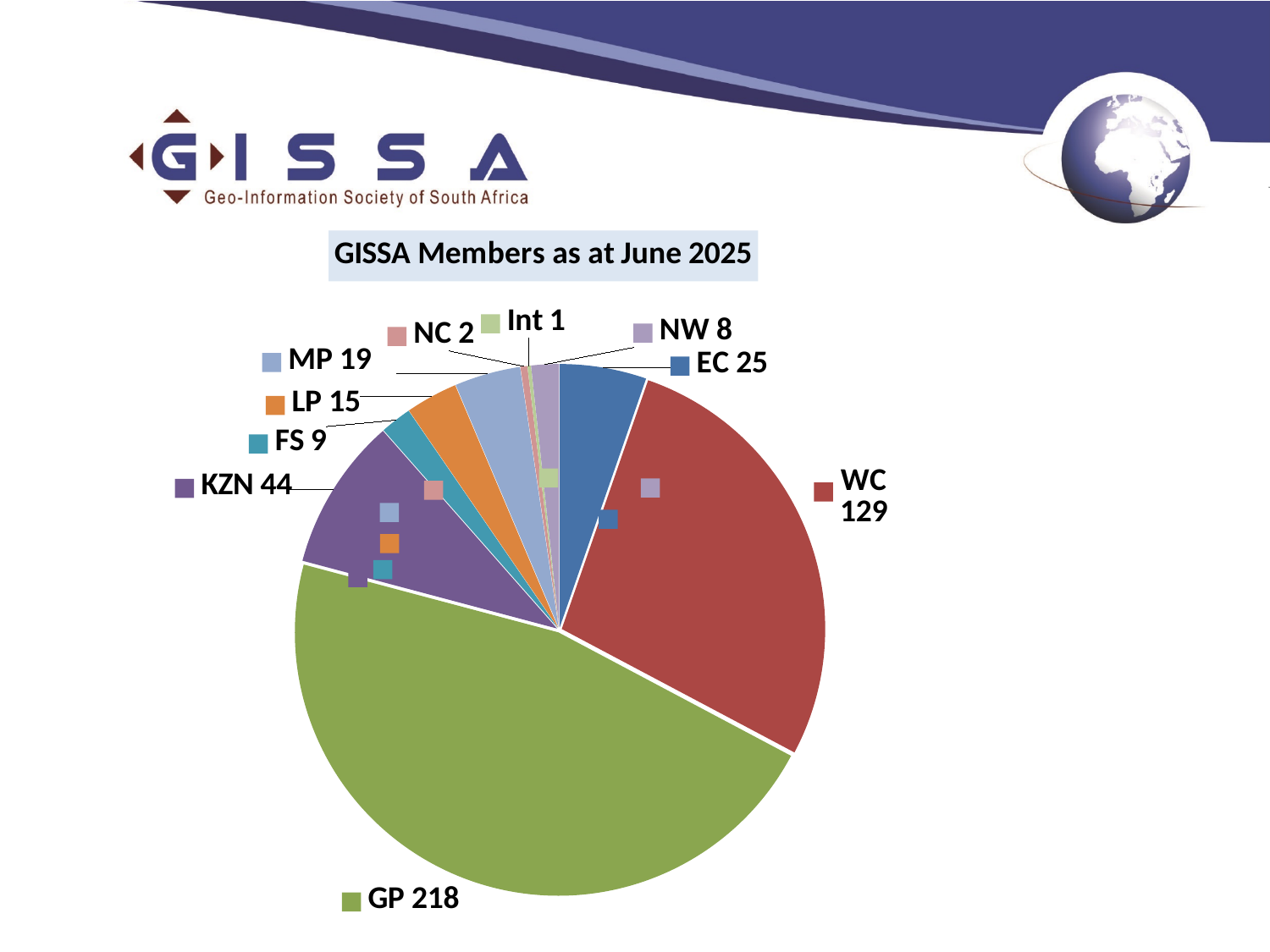
What is the title of the chart? GISSA Members as at June 2025 How many members does the chart show for EC? 25 Which has more members, MP or LP? MP What is the total number of members across all slices of the pie? 470 Which category has the largest slice of the pie? GP How many members does the chart show for WC? 129 How many categories are shown in the pie chart? 10 How many members does the chart show for KZN? 44 What kind of chart is shown on the slide? pie chart Which category has the smallest slice of the pie? Int What is the difference in members between GP and WC? 89 How many members does the chart show for GP? 218